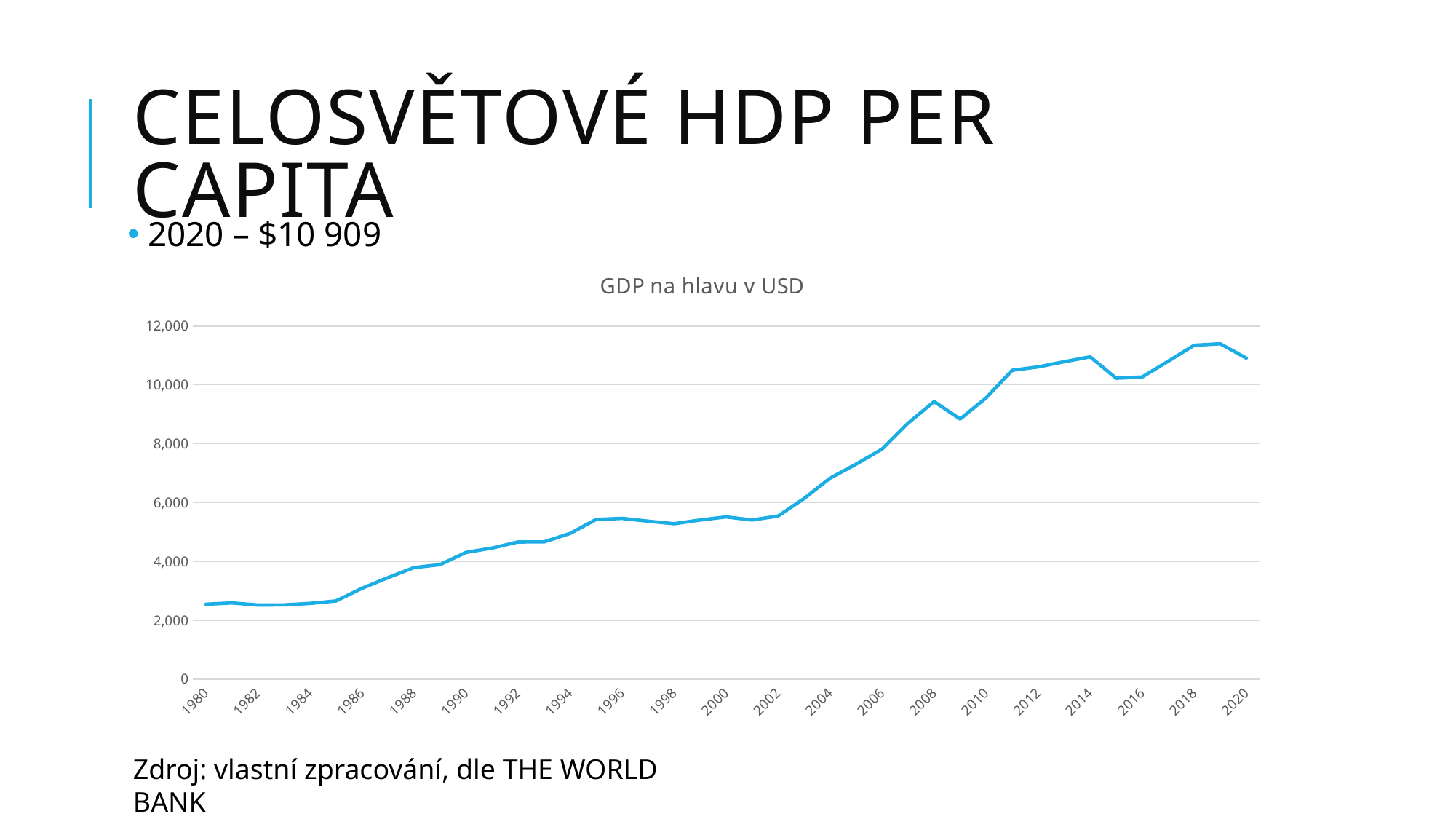
Overall, does GDP per capita rise or fall from 1980 to 2020? rise Which year has the higher value, 2008 or 2009? 2008 Is the value for 2012 greater or less than 10,000? greater How many year labels are shown on the x axis? 21 What kind of chart is shown on the slide? line chart Is the value for 2008 greater or less than 8,000? greater Is the value for 2000 greater or less than 6,000? less What is the title of the chart? GDP na hlavu v USD What is the world GDP per capita value for 2020 stated on the slide? $10 909 Which year has the higher value, 2019 or 2020? 2019